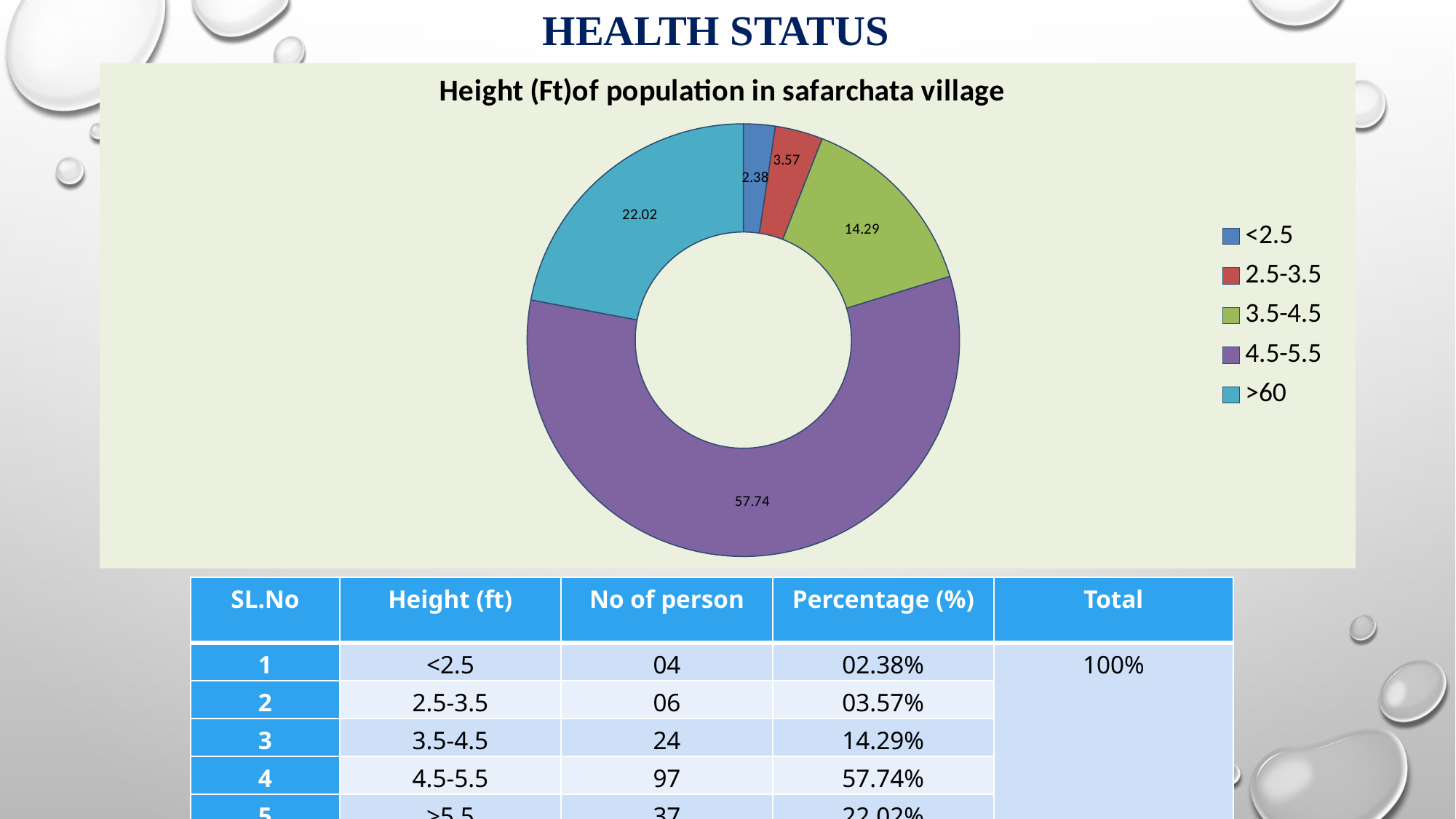
What is the difference between the values for 4.5-5.5 and >60? 35.72 What kind of chart is shown on the slide? Doughnut chart Which is larger, the value for 3.5-4.5 or the value for >60? >60 What is the value shown for the 3.5-4.5 category? 14.29 Which category has the largest slice? 4.5-5.5 What is the value shown for the >60 category? 22.02 What is the value shown for the <2.5 category? 2.38 How many categories does the chart's legend list? 5 Which category has the smallest slice? <2.5 What is the value shown for the 4.5-5.5 category? 57.74 What is the title of the chart? Height (Ft)of population in safarchata village What is the value shown for the 2.5-3.5 category? 3.57